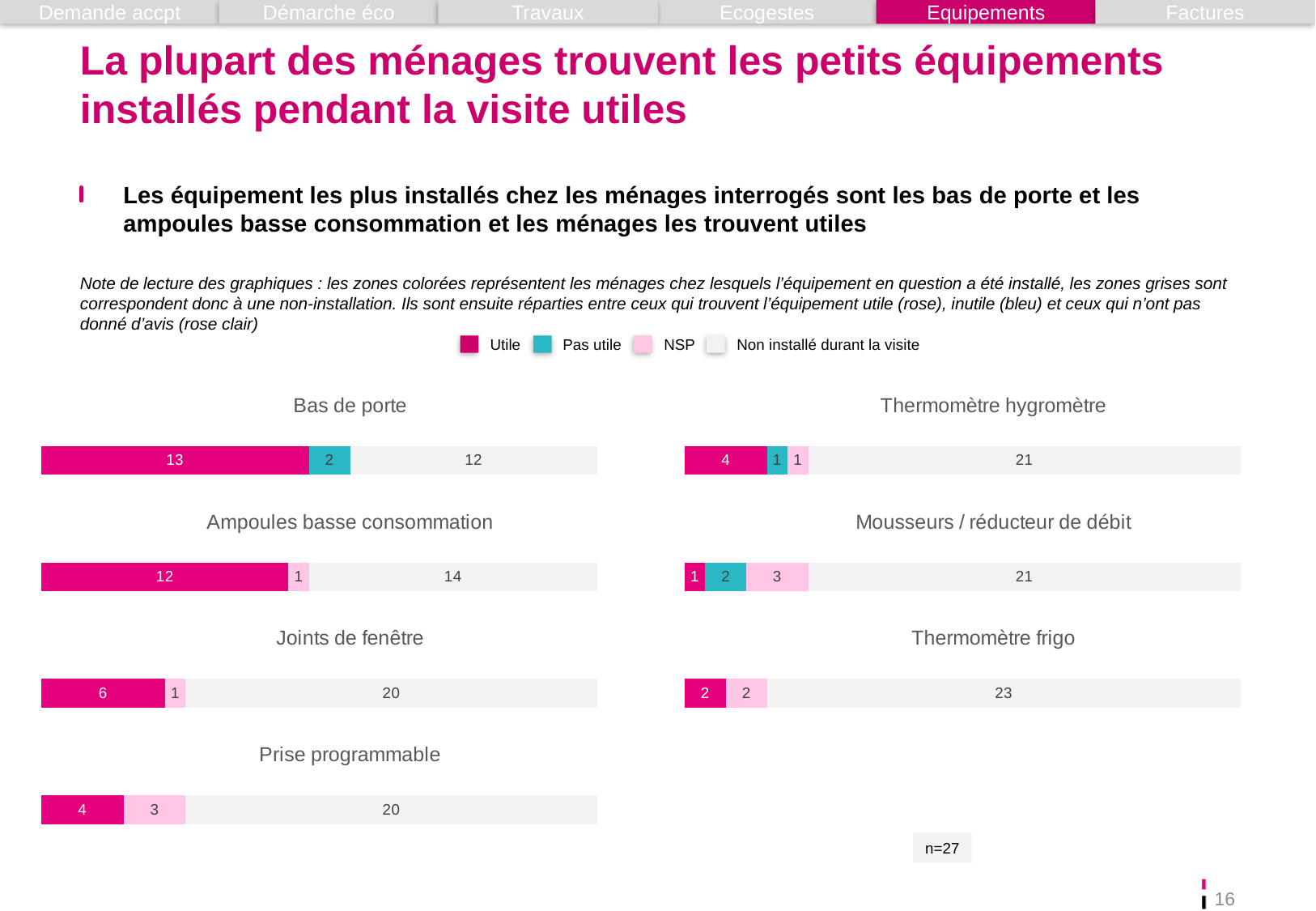
Across the seven charts, which equipment has the highest Utile value? Bas de porte In the 'Bas de porte' chart, what is the total of the stacked bar? 27 In the 'Prise programmable' chart, what is the value for Utile? 4 Across the seven charts, which equipment has the lowest Utile value? Mousseurs / réducteur de débit In the 'Thermomètre hygromètre' chart, what is the value for 'Non installé durant la visite'? 21 In the 'Thermomètre frigo' chart, what is the difference between 'Non installé durant la visite' and Utile? 21 In the 'Mousseurs / réducteur de débit' chart, what is the value for NSP? 3 How many series does the legend list? 4 In the 'Bas de porte' chart, how many households found the equipment useful (Utile)? 13 What kind of chart is used for 'Joints de fenêtre'? Stacked bar chart How many equipment charts are shown on the slide? 7 In the 'Ampoules basse consommation' chart, which is larger: Utile or 'Non installé durant la visite'? Non installé durant la visite